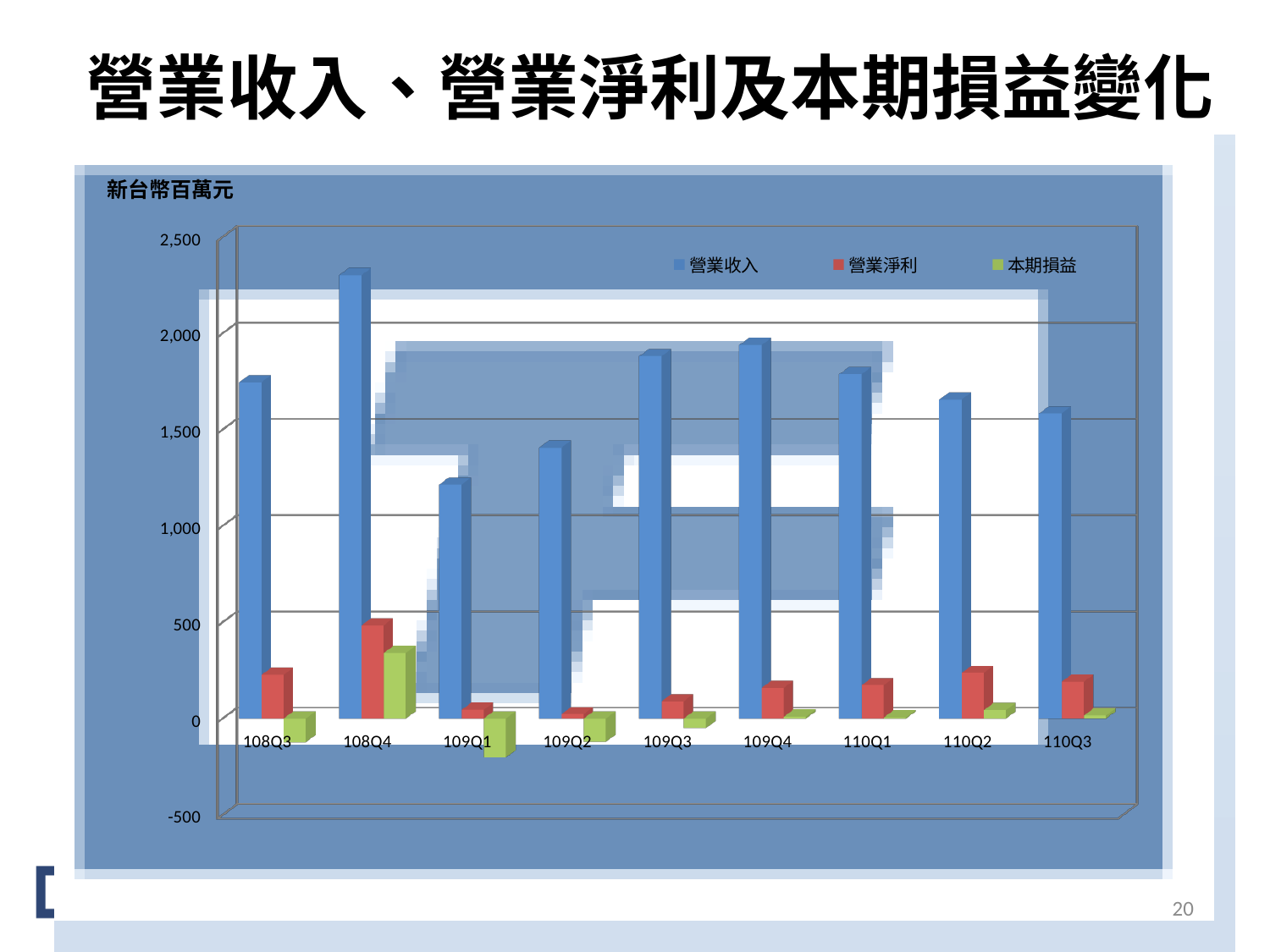
How many quarters are shown on the x axis of the chart? 9 Which quarter has the highest 營業收入? 108Q4 What kind of chart is shown on the slide? bar chart Is the 營業收入 value for 109Q1 greater or less than 1,500? less Which is larger, the 營業收入 for 108Q4 or for 109Q1? 108Q4 Does 營業收入 rise or fall from 109Q1 to 109Q4? rise Which quarter has the lowest 營業收入? 109Q1 Is the 營業收入 value for 108Q4 greater or less than 2,000? greater How many series does the chart's legend list? 3 Is the 本期損益 value for 109Q1 greater or less than 0? less Which quarter has the highest 營業淨利? 108Q4 Which quarter has the lowest 本期損益? 109Q1